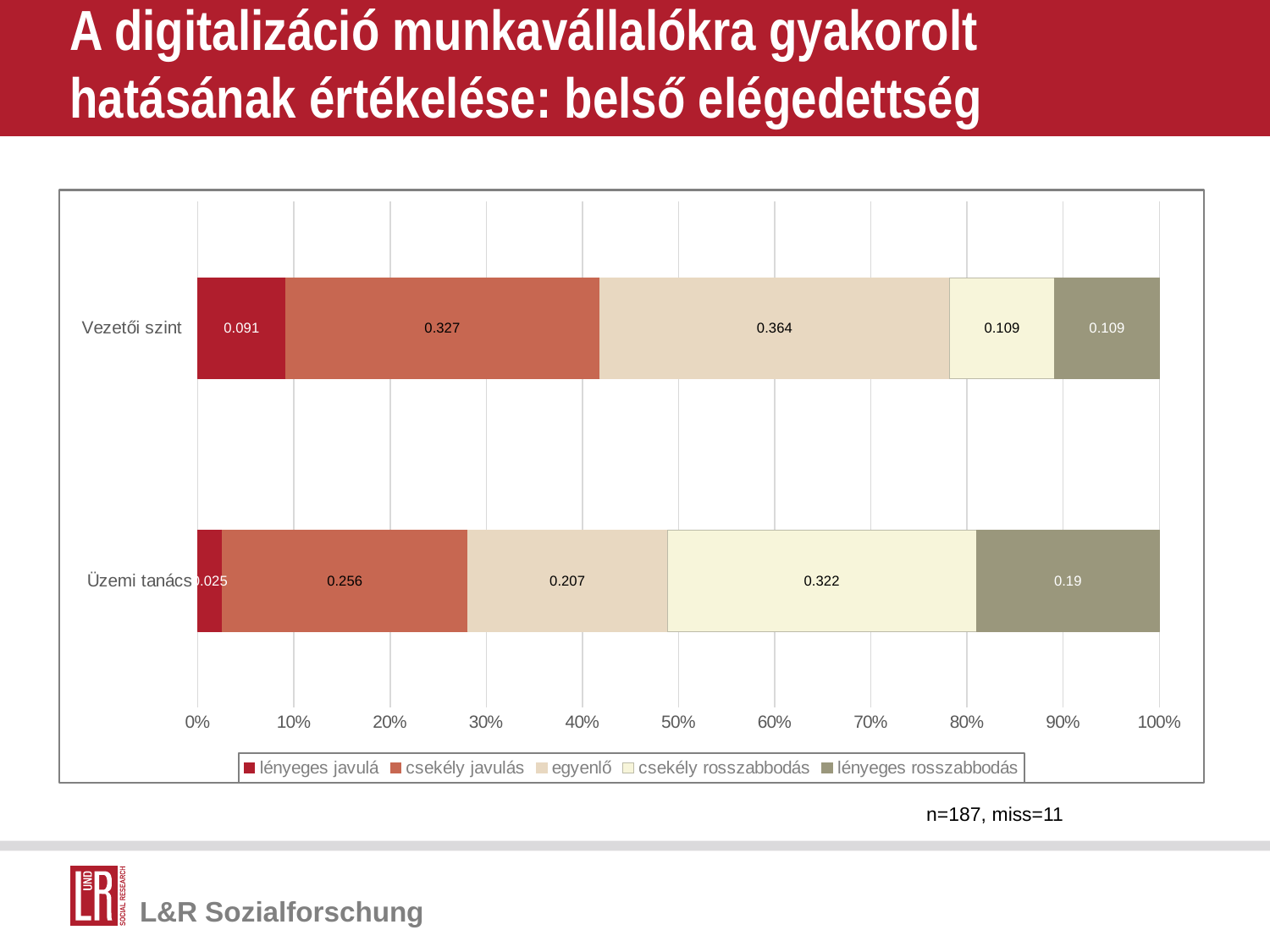
What is the value of the 'egyenlő' segment for Vezetői szint? 0.364 What is the difference between the 'lényeges rosszabbodás' values for Üzemi tanács and Vezetői szint? 0.081 What is the value of the 'csekély rosszabbodás' segment for Üzemi tanács? 0.322 How many categories (bars) are shown in the chart? 2 Which segment is the largest in the Üzemi tanács bar? csekély rosszabbodás Which category has the larger 'csekély javulás' value, Vezetői szint or Üzemi tanács? Vezetői szint What is the value of the 'csekély javulás' segment for Vezetői szint? 0.327 What is the difference between the 'egyenlő' values for Vezetői szint and Üzemi tanács? 0.157 How many series does the legend list? 5 What is the value of the 'lényeges rosszabbodás' segment for Üzemi tanács? 0.19 Which segment is the largest in the Vezetői szint bar? egyenlő What kind of chart is shown on the slide? Stacked bar chart